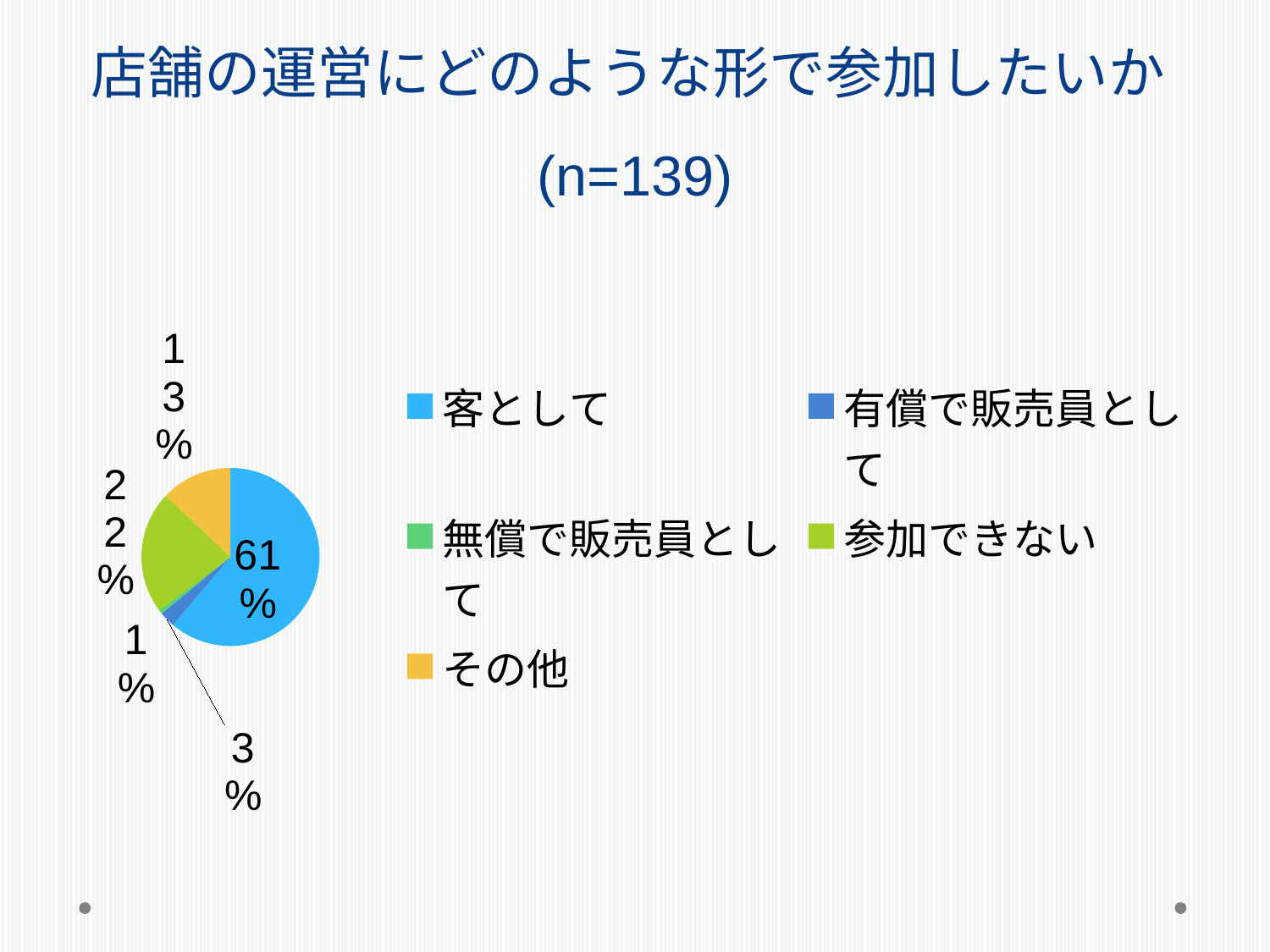
What percentage of respondents chose 有償で販売員として? 3% What is the difference in percentage points between 客として and 参加できない? 39 What is the sample size (n) shown in the chart title? 139 What percentage of respondents chose その他? 13% What percentage of respondents chose 客として? 61% Which category has the largest share of the pie? 客として What percentage of respondents chose 無償で販売員として? 1% What percentage of respondents chose 参加できない? 22% Which category has the smallest share of the pie? 無償で販売員として What kind of chart is shown on the slide? pie chart How many categories does the legend list? 5 Which is larger, the share for 参加できない or the share for その他? 参加できない